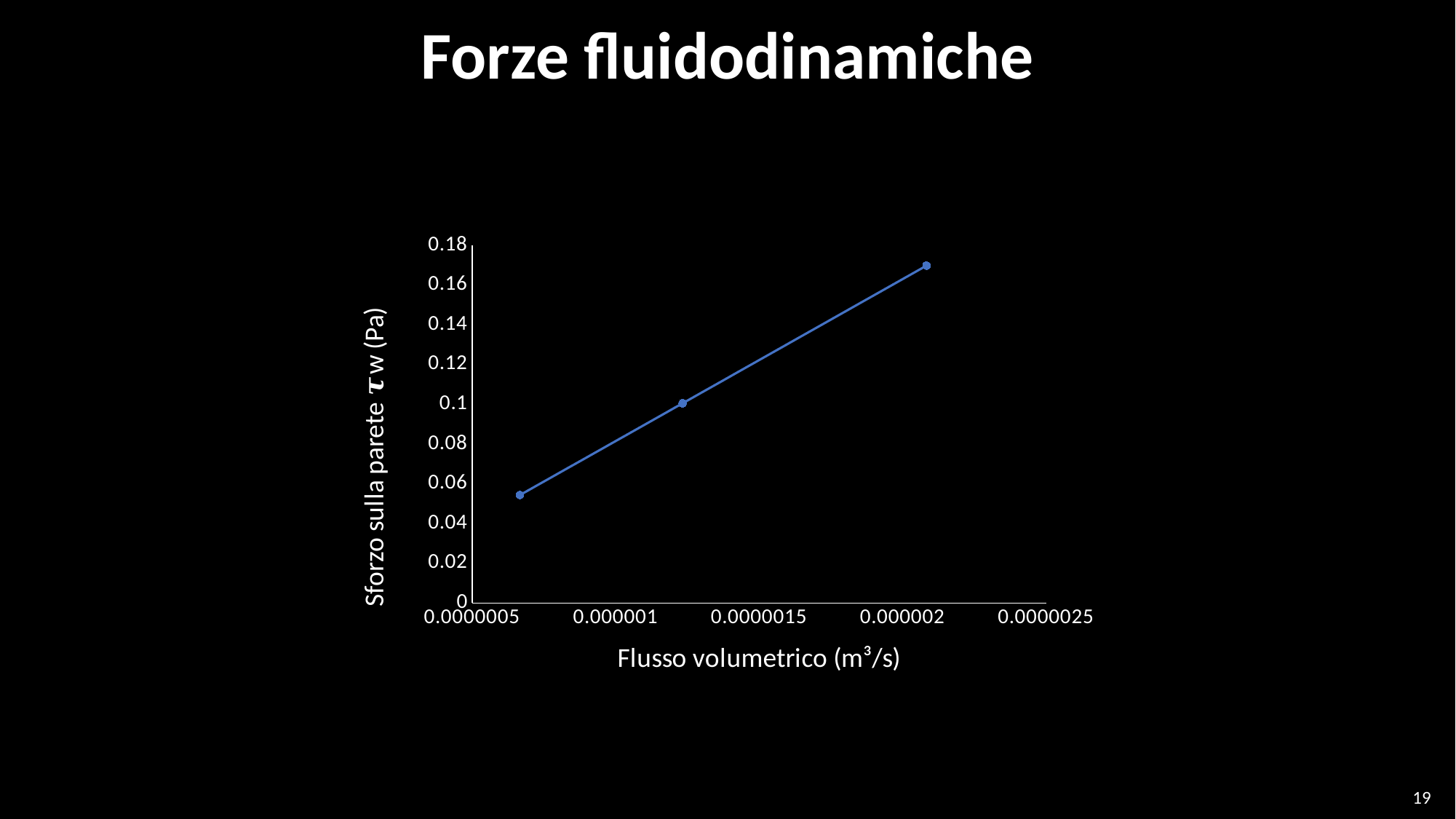
What kind of chart is shown on the slide? line chart Is the volumetric flow of the leftmost point greater or less than 0.000001? less What is the label of the x axis? Flusso volumetrico (m³/s) Is the wall stress value of the middle point greater or less than 0.12? less Which point has the lowest wall stress: the leftmost, the middle, or the rightmost? the leftmost Is the wall stress value of the rightmost point greater or less than 0.16? greater Which point has the highest wall stress: the leftmost, the middle, or the rightmost? the rightmost How many data points are plotted on the chart? 3 Does the wall stress rise or fall as the volumetric flow increases along the x axis? rise What is the highest tick value shown on the y axis? 0.18